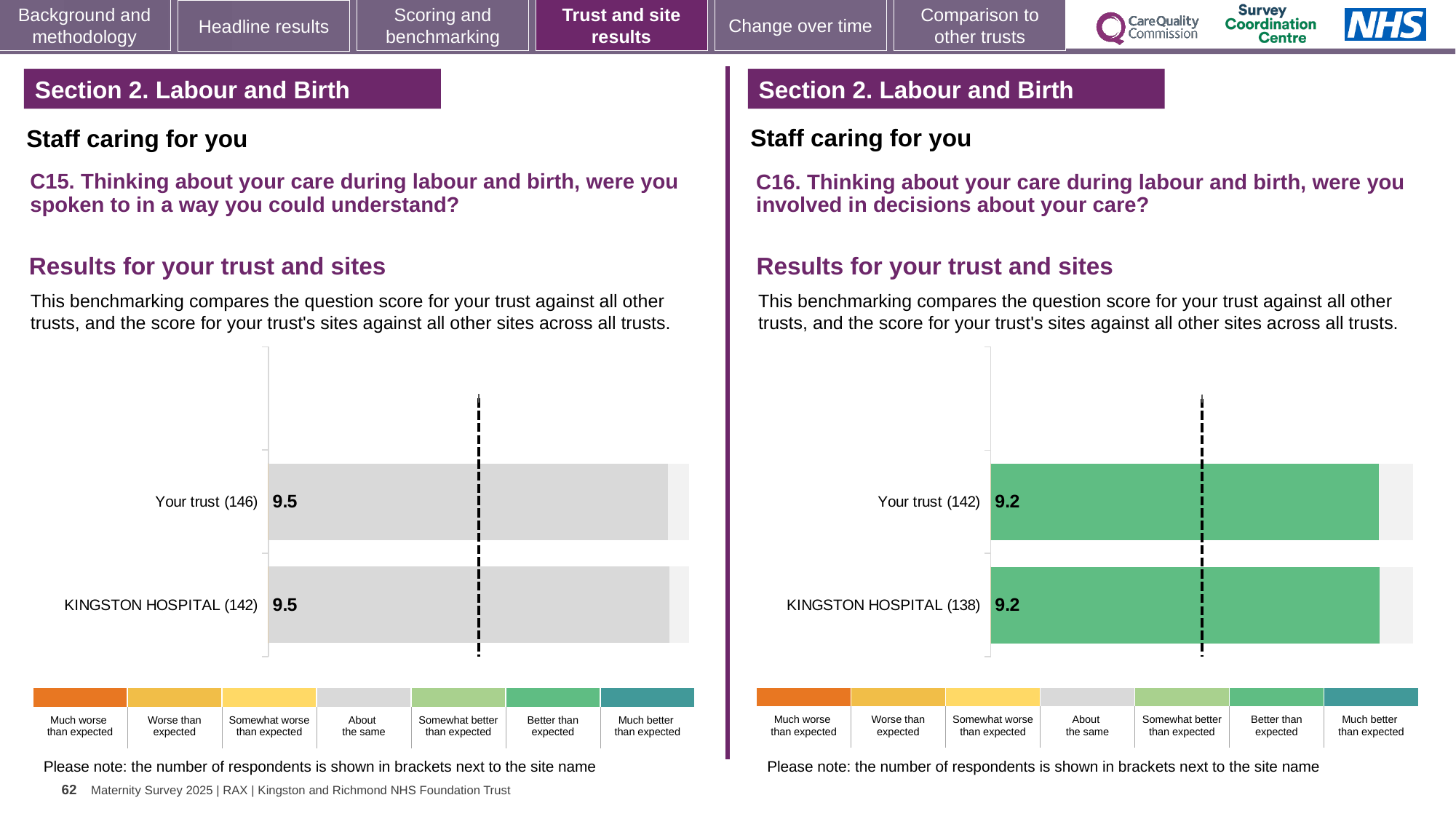
According to the colour key, which benchmark category do the green bars in the C16 chart on the right represent? Better than expected In the C15 chart on the left, how many respondents are shown in brackets for Your trust? 146 How many bars are plotted in the C16 chart on the right? 2 In the C15 chart on the left, what is the score for KINGSTON HOSPITAL? 9.5 In the C15 chart on the left, what is the difference between the Your trust score and the KINGSTON HOSPITAL score? 0 In the C15 chart on the left, what is the score for Your trust? 9.5 In the C16 chart on the right, how many respondents are shown in brackets for KINGSTON HOSPITAL? 138 What type of chart is used for the C15 results on the left? Bar chart In the C16 chart on the right, what is the difference between the Your trust score and the KINGSTON HOSPITAL score? 0 In the C16 chart on the right, what is the score for KINGSTON HOSPITAL? 9.2 How many bars are plotted in the C15 chart on the left? 2 In the C16 chart on the right, what is the score for Your trust? 9.2